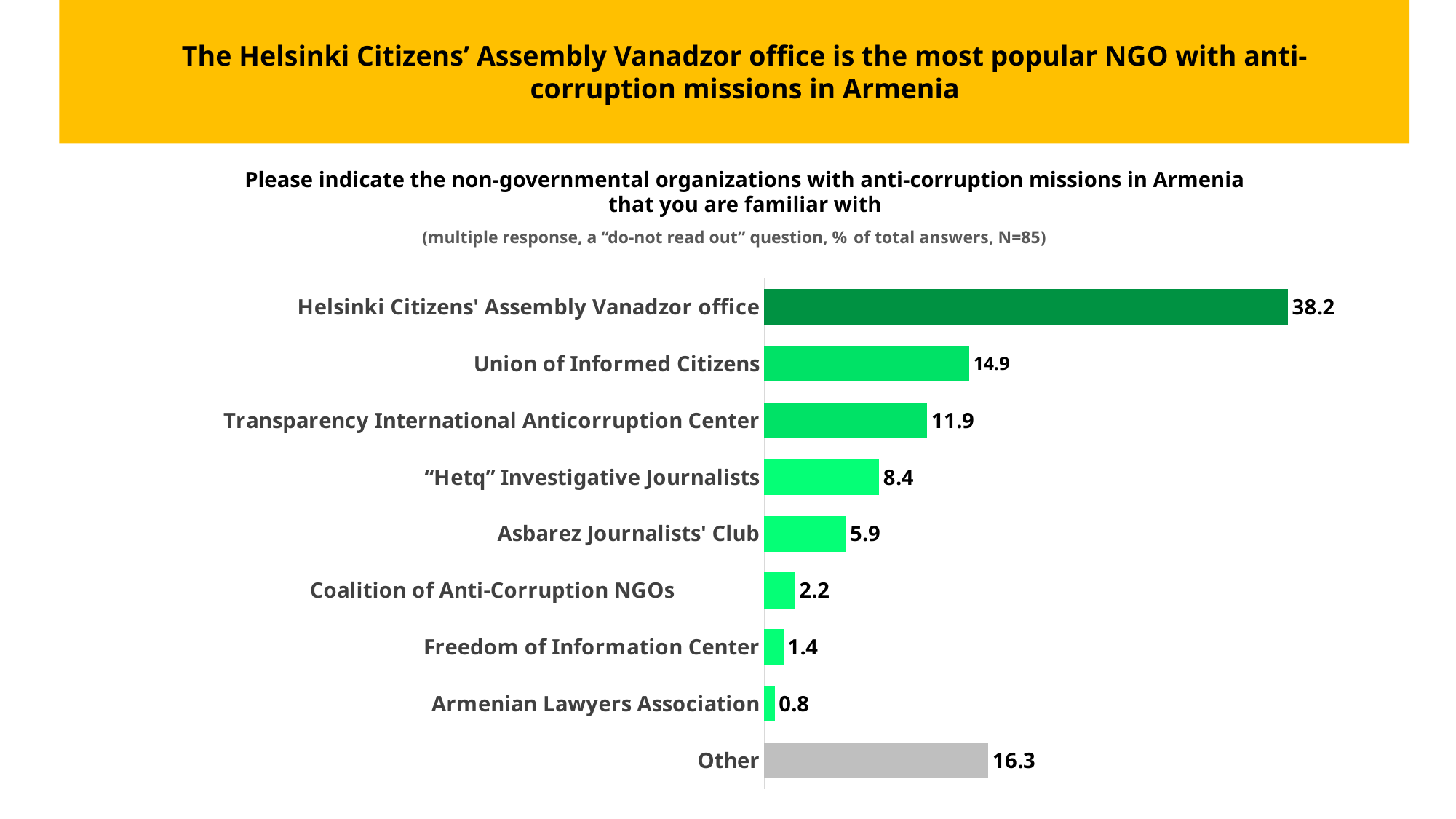
What is the difference between the values for Helsinki Citizens' Assembly Vanadzor office and Union of Informed Citizens? 23.3 What is the value for “Hetq” Investigative Journalists? 8.4 What is the value for Union of Informed Citizens? 14.9 Which is larger, the value for Asbarez Journalists' Club or the value for Coalition of Anti-Corruption NGOs? Asbarez Journalists' Club Which category has the lowest value? Armenian Lawyers Association What is the sample size (N) stated in the chart subtitle? N=85 What kind of chart is shown on the slide? Bar chart What is the value for Helsinki Citizens' Assembly Vanadzor office? 38.2 What is the value for the Other category? 16.3 What is the value for Transparency International Anticorruption Center? 11.9 How many categories are shown in the chart? 9 Which named organization has the highest value? Helsinki Citizens' Assembly Vanadzor office